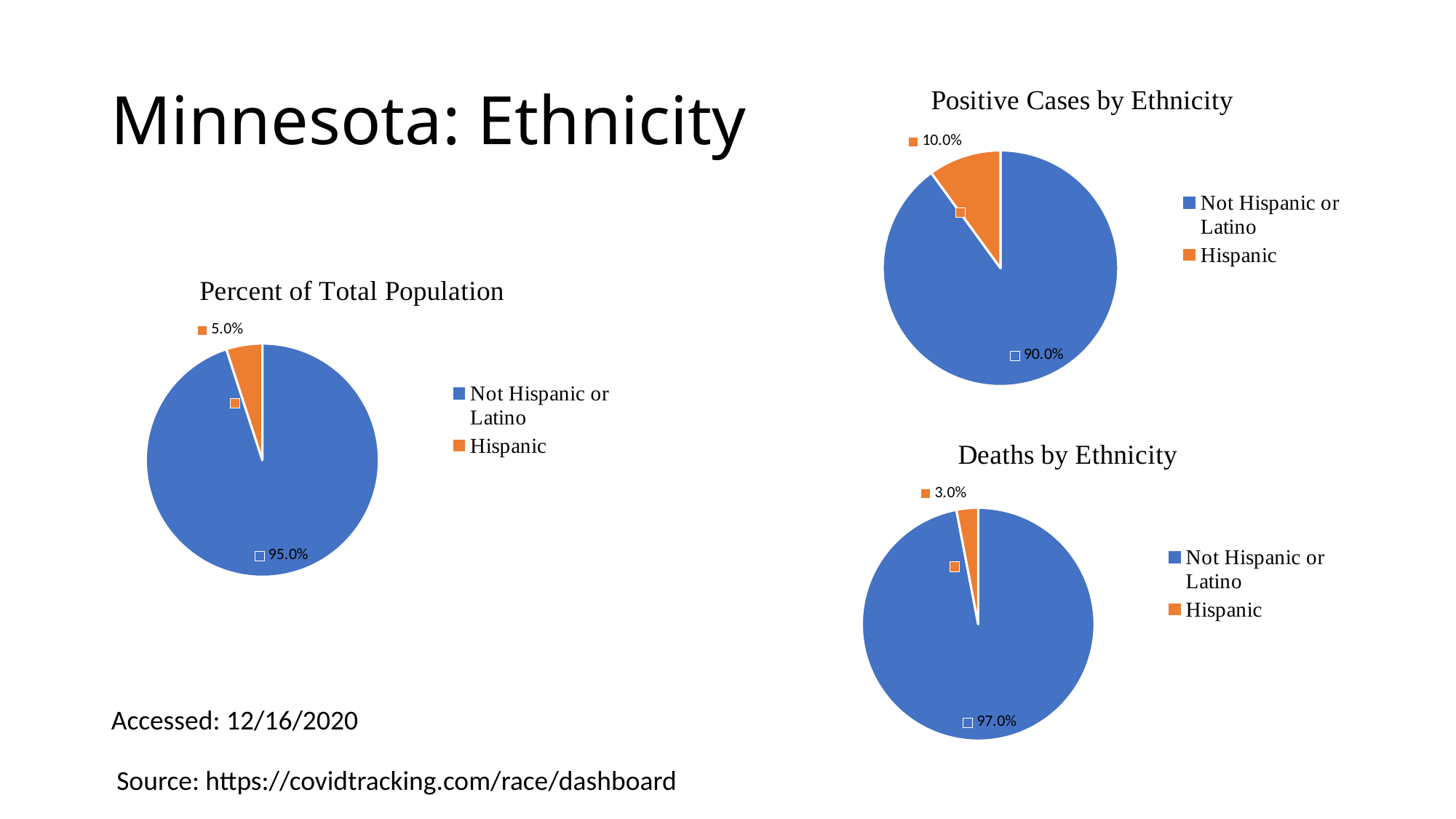
In the 'Positive Cases by Ethnicity' chart, which category has the largest slice? Not Hispanic or Latino In the 'Deaths by Ethnicity' chart, what is the value for Not Hispanic or Latino? 97.0% In the 'Positive Cases by Ethnicity' chart, what is the difference between the Not Hispanic or Latino and Hispanic shares? 80.0% In the 'Percent of Total Population' chart, what is the value for Not Hispanic or Latino? 95.0% How many categories does the legend of the 'Percent of Total Population' chart list? 2 In the 'Positive Cases by Ethnicity' chart, what share of the pie is Not Hispanic or Latino? 90.0% In the 'Deaths by Ethnicity' chart, what is the value for Hispanic? 3.0% What kind of chart is the 'Deaths by Ethnicity' chart? Pie chart In the 'Deaths by Ethnicity' chart, which category has the smallest slice? Hispanic In the 'Positive Cases by Ethnicity' chart, what is the value for Hispanic? 10.0% Which is larger: the Hispanic share in the 'Positive Cases by Ethnicity' chart or the Hispanic share in the 'Deaths by Ethnicity' chart? Positive Cases by Ethnicity In the 'Percent of Total Population' chart, what share of the pie is Hispanic? 5.0%